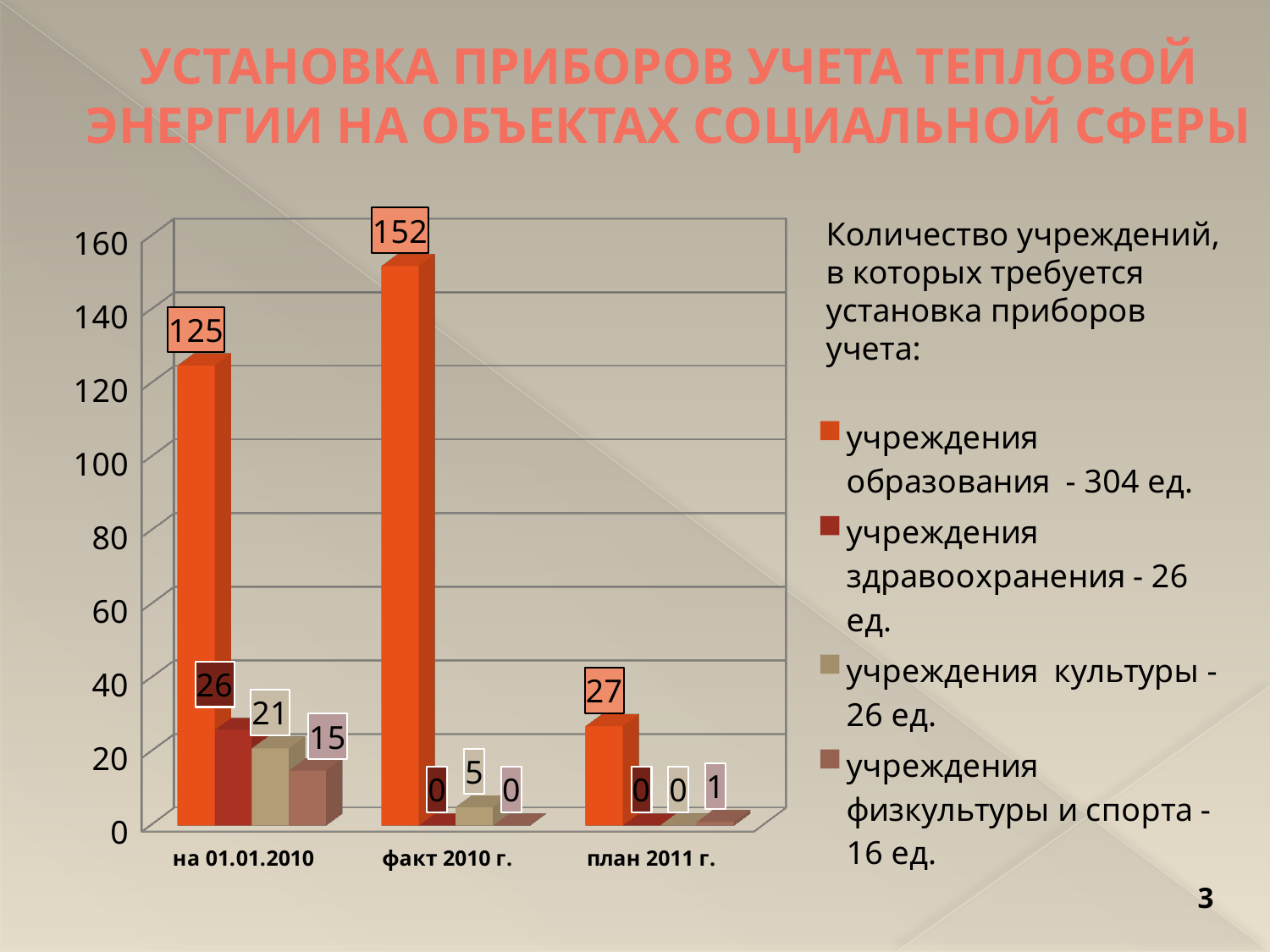
In which category is the value for учреждения образования the lowest? план 2011 г. What is the value for учреждения здравоохранения in the category на 01.01.2010? 26 What is the value for учреждения культуры in the category на 01.01.2010? 21 Which is larger: the учреждения культуры value for на 01.01.2010 or for факт 2010 г.? на 01.01.2010 How many categories are shown on the x axis? 3 What kind of chart is shown on the slide? bar chart In which category is the value for учреждения образования the highest? факт 2010 г. What is the difference between the учреждения образования values for факт 2010 г. and на 01.01.2010? 27 How many series does the legend list? 4 What is the value for учреждения физкультуры и спорта in the category план 2011 г.? 1 What is the total of all four series for the category на 01.01.2010? 187 What is the value for учреждения образования in the category факт 2010 г.? 152